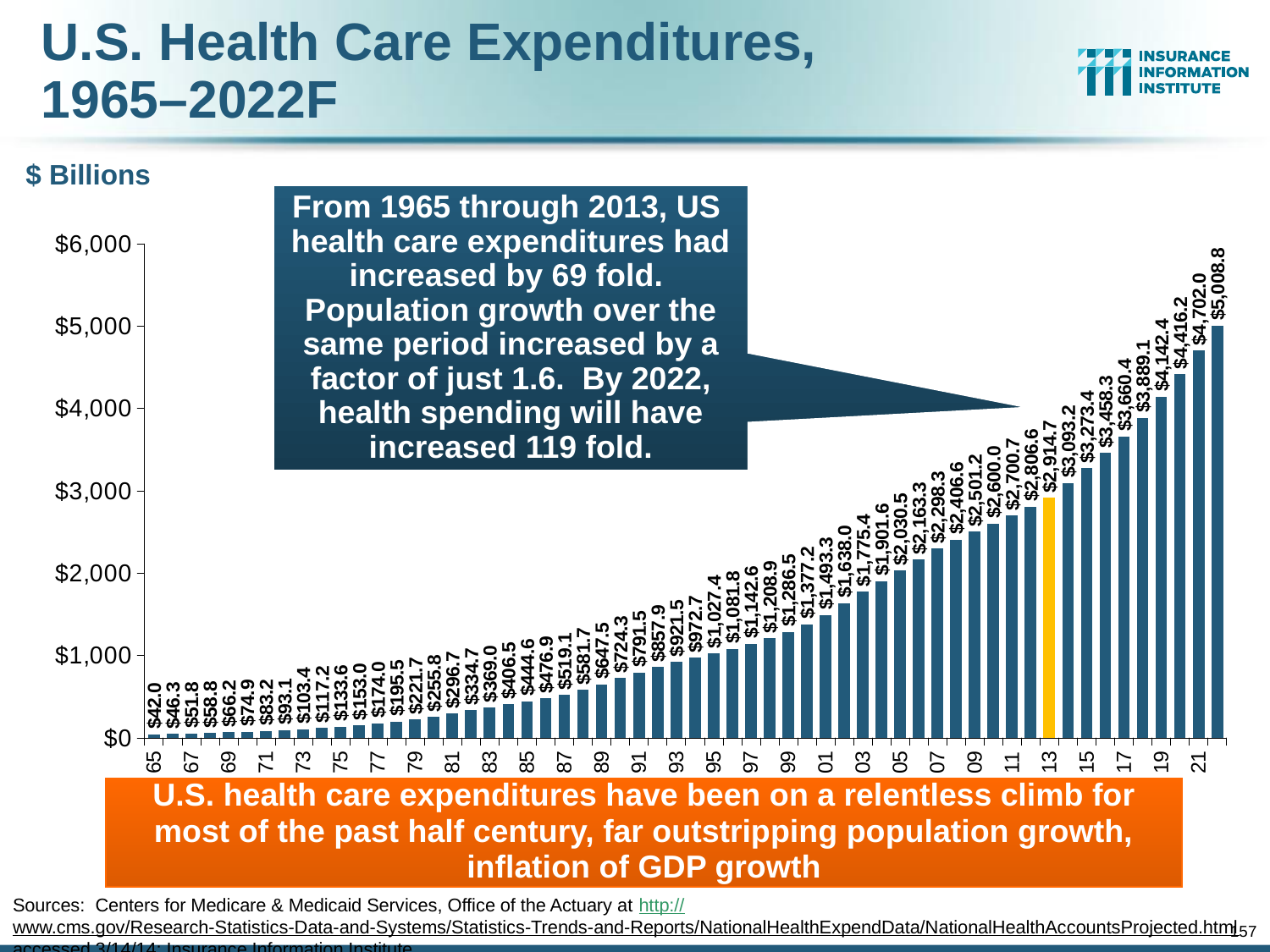
Which year has the highest health care expenditure in the chart? 2022 (last bar, $5,008.8) What is the value of the last bar (2022F) in the chart? $5,008.8 What is the difference between the 2022F value and the 1965 value? $4,966.8 Which year has the lowest health care expenditure in the chart? 1965 ($42.0) What type of chart is shown on the slide? bar chart What is the value shown for 2005 (label '05')? $2,030.5 Is the value for 2013 greater or less than $3,000? less What unit is indicated for the y axis of the chart? $ Billions What is the value of the highlighted (yellow) bar for 2013? $2,914.7 What is the value of the first bar (1965) in the U.S. Health Care Expenditures chart? $42.0 What is the value shown for 1995 (label '95')? $1,027.4 Do health care expenditures rise or fall from 1965 to 2022 along the x axis? rise